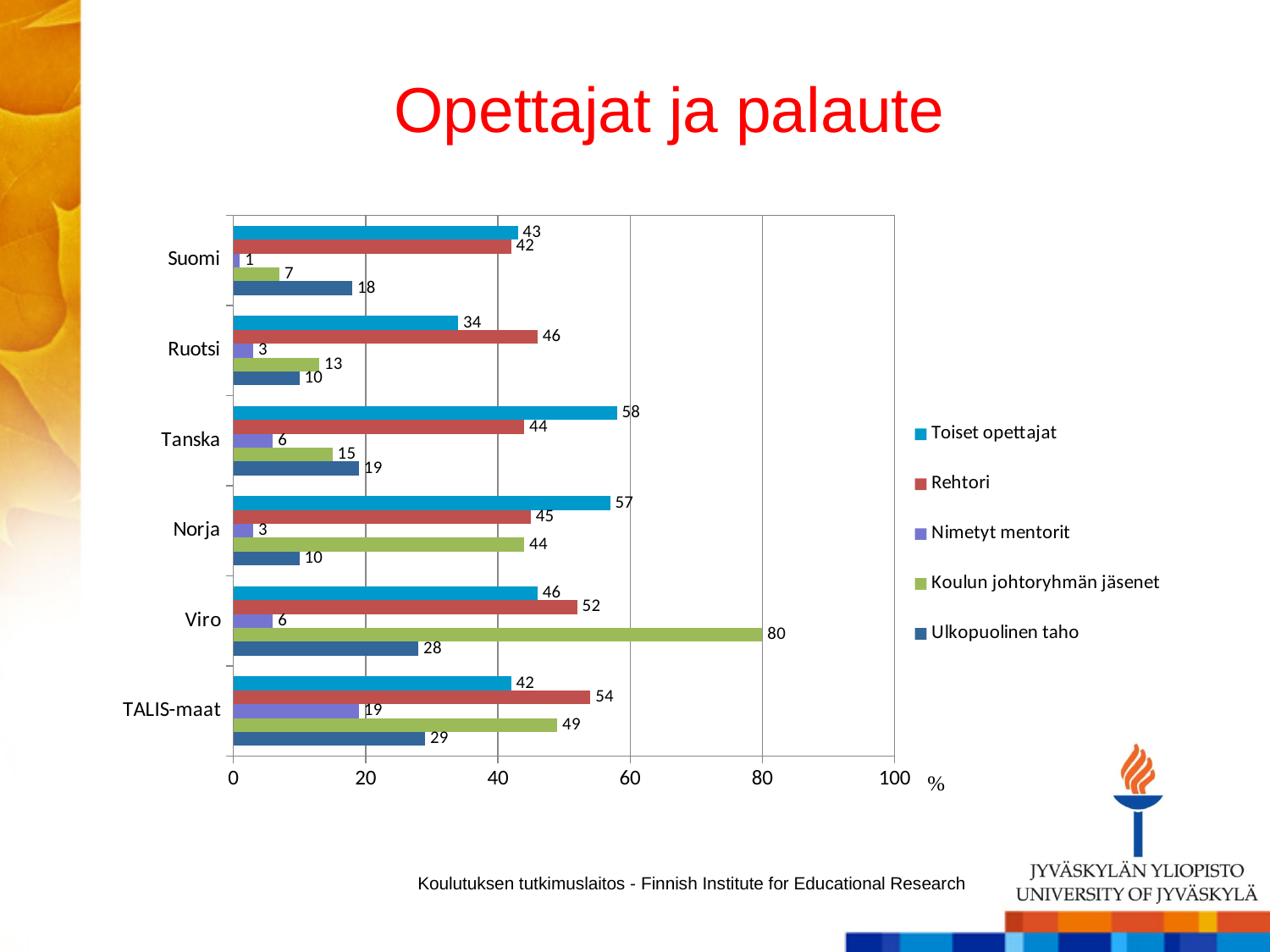
How many countries or groups are shown on the y axis? 6 What is the value for Toiset opettajat in Tanska? 58 Which country has the highest value for Rehtori? TALIS-maat How many series does the legend list? 5 What is the difference between the Rehtori value and the Toiset opettajat value for Ruotsi? 12 Which category has the lowest value for Koulun johtoryhmän jäsenet? Suomi What is the value for Nimetyt mentorit in Suomi? 1 Which is larger for Norja: Toiset opettajat or Rehtori? Toiset opettajat What is the value for Ulkopuolinen taho in TALIS-maat? 29 What kind of chart is shown on the slide? Bar chart What is the value for Koulun johtoryhmän jäsenet in Viro? 80 What is the title of the slide? Opettajat ja palaute